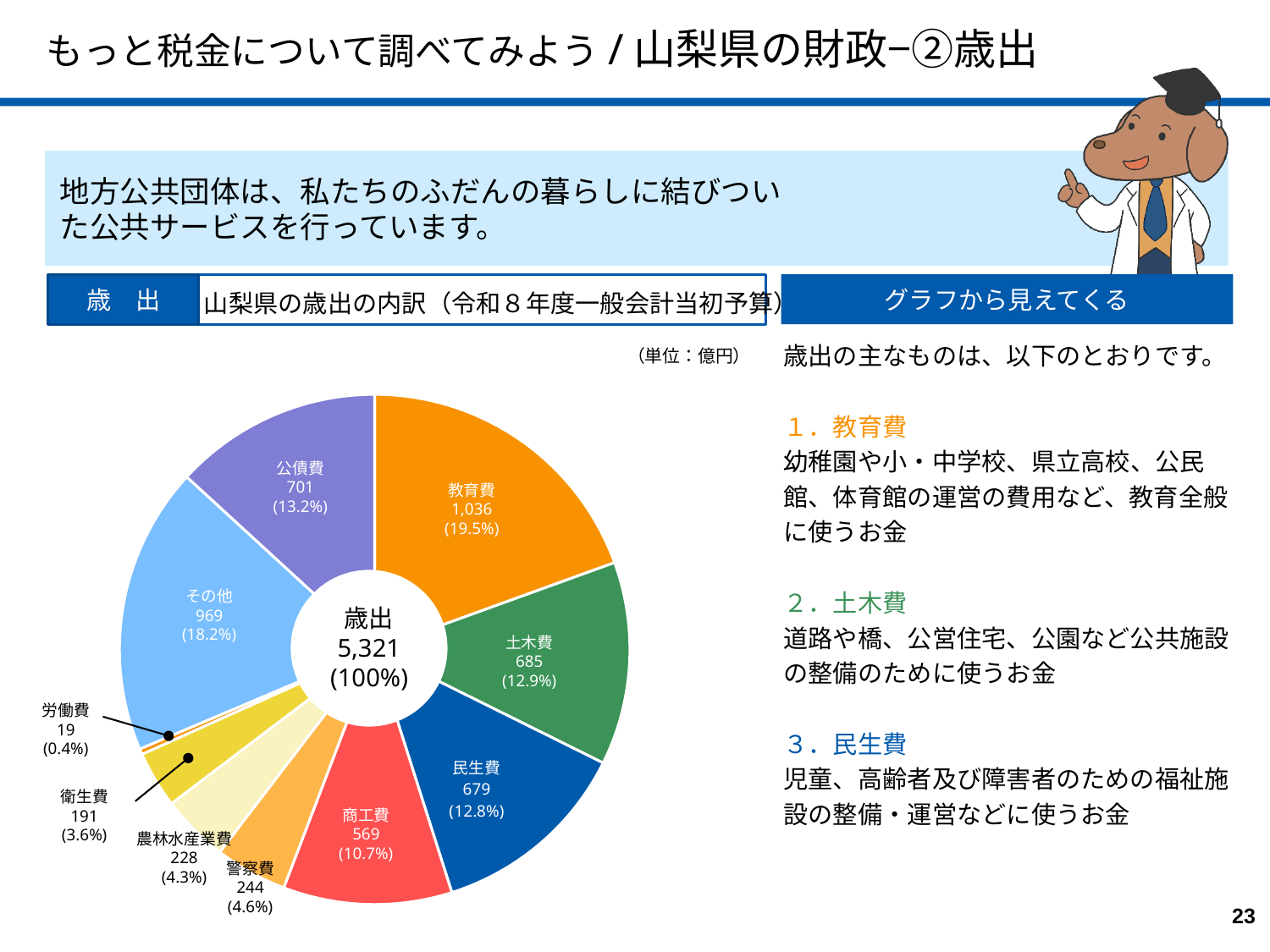
What unit is stated for the values in the pie chart? 億円 What is the difference between the values for 教育費 and 公債費? 335 Which category has the smallest value in the pie chart? 労働費 What is the value for 民生費 in the pie chart? 679 Which category has the largest value in the pie chart? 教育費 What is the total value shown in the centre of the pie chart? 5,321 What percentage share does その他 have in the pie chart? 18.2% Which is larger, 商工費 or 警察費? 商工費 What is the value for 教育費 in the pie chart? 1,036 What type of chart is shown on the slide? pie chart What percentage share does 土木費 have in the pie chart? 12.9% How many categories are shown in the pie chart? 10